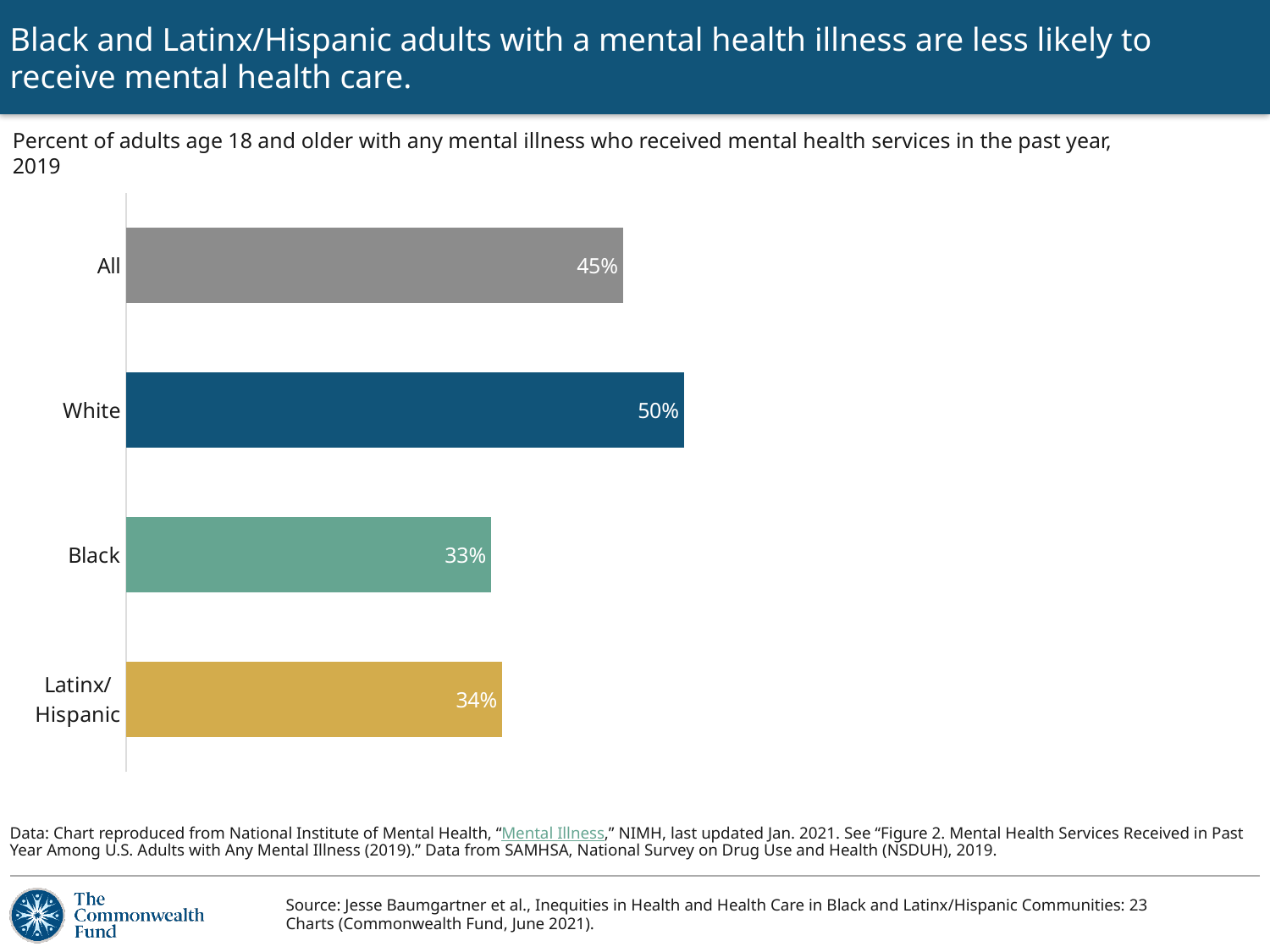
What is the difference in percentage points between White adults and Black adults? 17 What is the value shown for Black adults? 33% What percent of all adults with any mental illness received mental health services in the past year? 45% What year does the chart's data refer to? 2019 What is the difference in percentage points between the All group and Latinx/Hispanic adults? 11 Which is larger, the value for White adults or the value for All adults? White What is the value shown for Latinx/Hispanic adults? 34% How many groups are shown in the chart? 4 What is the value shown for White adults? 50% Which group has the lowest percentage receiving mental health services? Black Which group has the highest percentage receiving mental health services? White What type of chart is shown on the slide? Bar chart